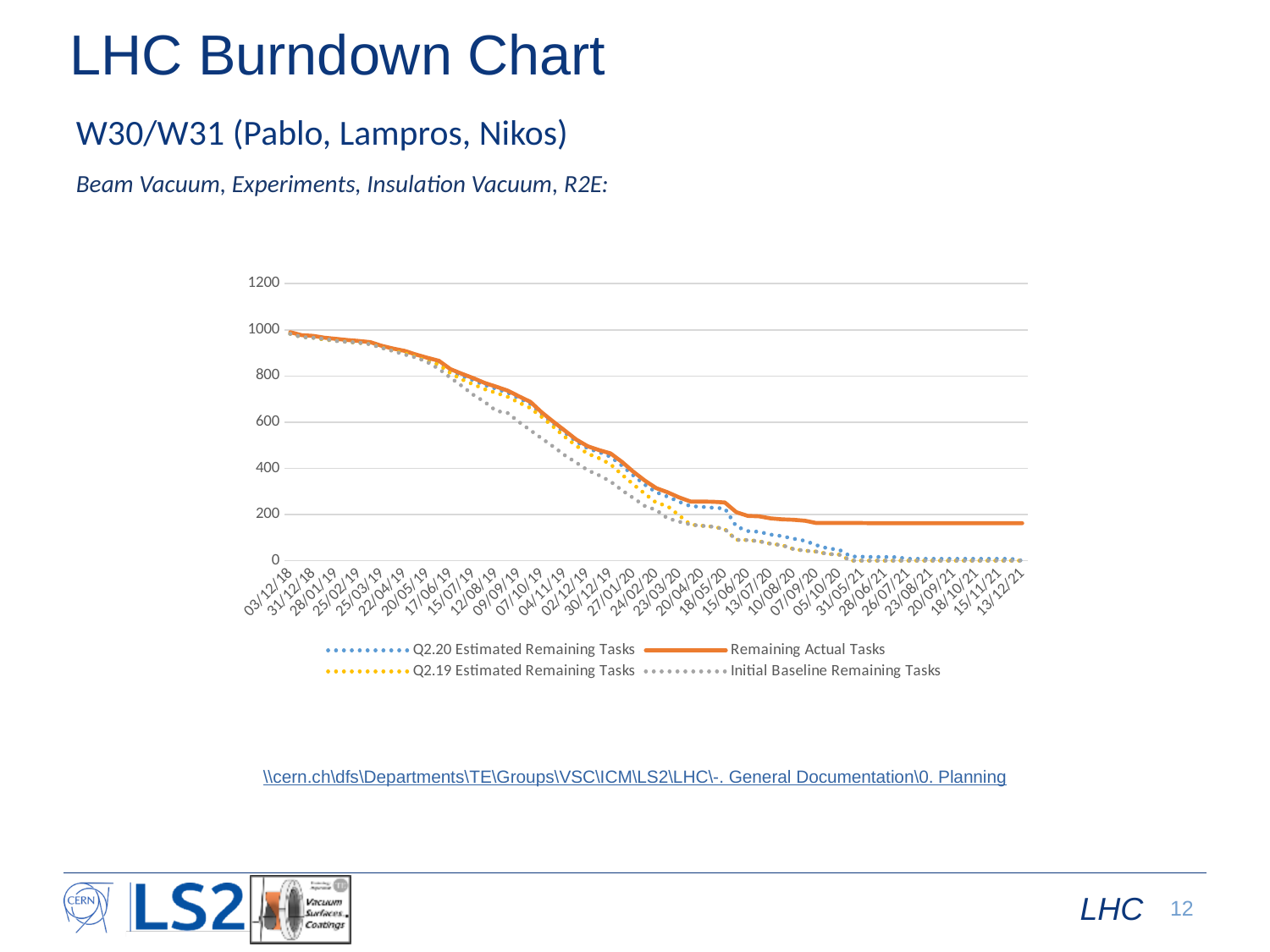
Is the value for Remaining Actual Tasks at 17/06/19 greater or less than 600? greater How many series does the chart legend list? 4 What kind of chart is shown on the slide? line chart Does the Remaining Actual Tasks series rise or fall along the x axis? fall Is the value for Remaining Actual Tasks at 03/12/18 greater or less than 800? greater Is the value for Remaining Actual Tasks at 13/12/21 greater or less than 200? less At 12/08/19, which is larger: Remaining Actual Tasks or Initial Baseline Remaining Tasks? Remaining Actual Tasks Which series in the legend is drawn as a solid line rather than a dotted line? Remaining Actual Tasks What is the highest value shown on the chart's y axis? 1200 At 13/12/21, which is larger: Remaining Actual Tasks or Initial Baseline Remaining Tasks? Remaining Actual Tasks Does the Initial Baseline Remaining Tasks series rise or fall along the x axis? fall